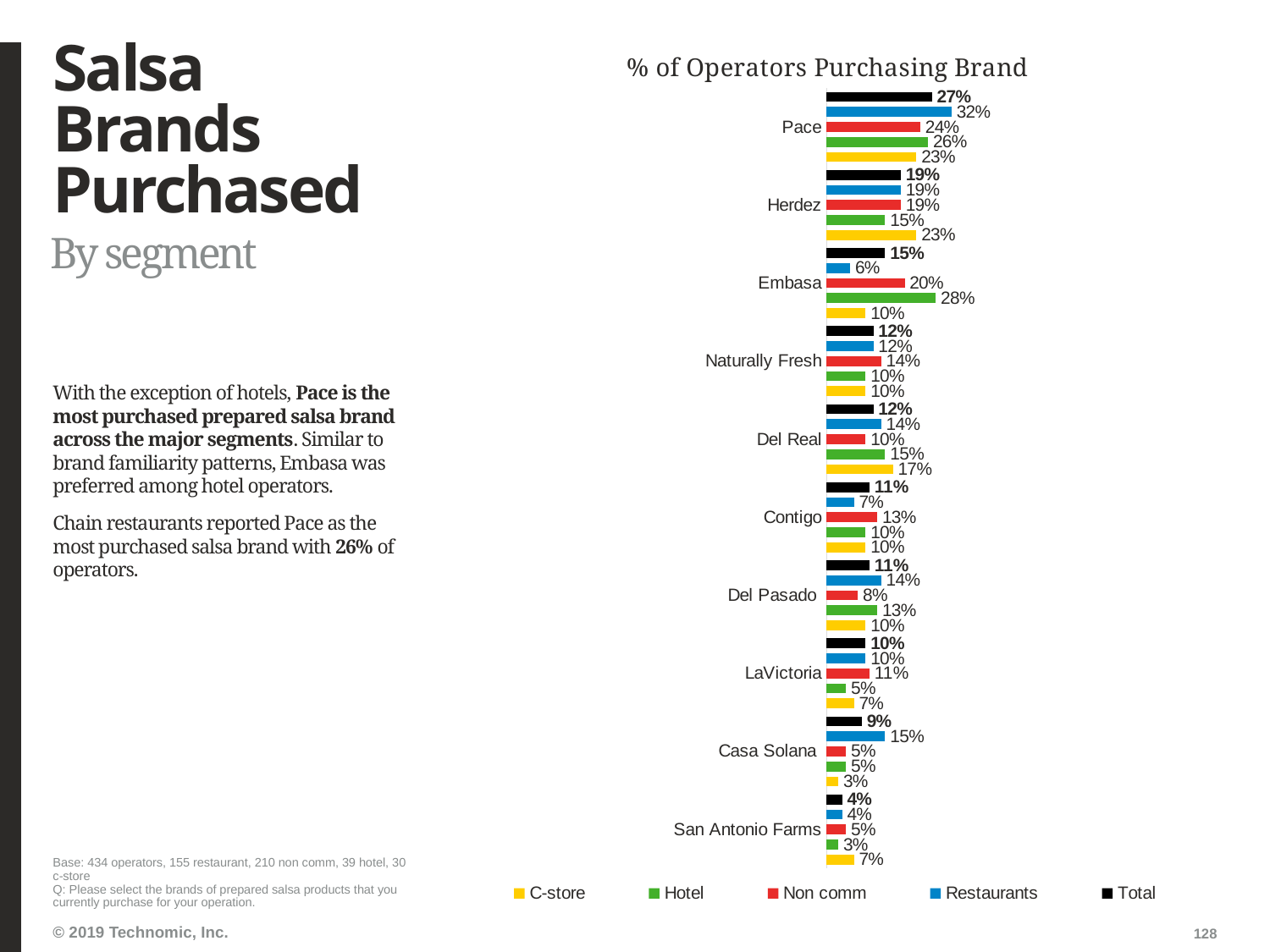
What percentage of Hotel operators purchase Embasa? 28% What is the difference between the Restaurants and Hotel values for Embasa? 22% What is the Total value for Pace? 27% What is the C-store value for Herdez? 23% What is the Restaurants value for Casa Solana? 15% How many series does the legend list? 5 Which is larger for Del Real: the C-store value or the Non comm value? C-store How many brands are shown in the chart? 10 Which brand has the lowest Total value? San Antonio Farms Which brand has the highest Total value? Pace What type of chart is shown on the slide? Bar chart What is the title of the chart? % of Operators Purchasing Brand